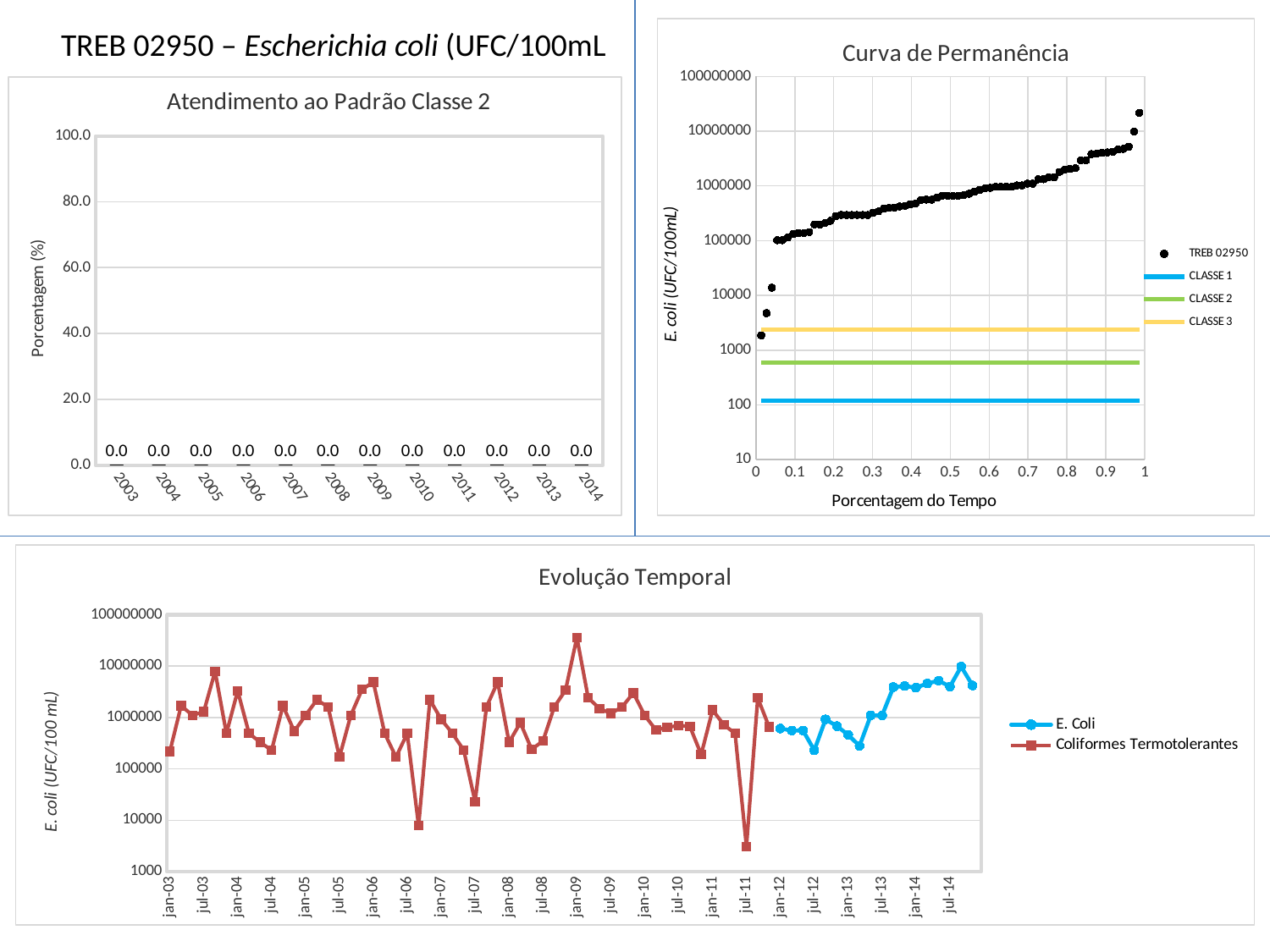
In the 'Atendimento ao Padrão Classe 2' chart, what is the value for 2010? 0.0 How many series does the legend of the 'Evolução Temporal' chart list? 2 How many years are shown on the x axis of the 'Atendimento ao Padrão Classe 2' chart? 12 In the 'Evolução Temporal' chart, is the highest Coliformes Termotolerantes value (around jan-09) greater or less than 10000000? greater In the 'Curva de Permanência' chart, is the CLASSE 2 line greater or less than 1000? less In the 'Curva de Permanência' chart, is the CLASSE 3 line greater or less than 1000? greater How many entries does the legend of the 'Curva de Permanência' chart list? 4 In the 'Evolução Temporal' chart, which series is plotted in red? Coliformes Termotolerantes What kind of chart is 'Atendimento ao Padrão Classe 2'? bar chart What kind of chart is 'Evolução Temporal'? line chart What is the x-axis title of the 'Curva de Permanência' chart? Porcentagem do Tempo In the 'Curva de Permanência' chart, do the TREB 02950 values rise or fall as Porcentagem do Tempo increases? rise